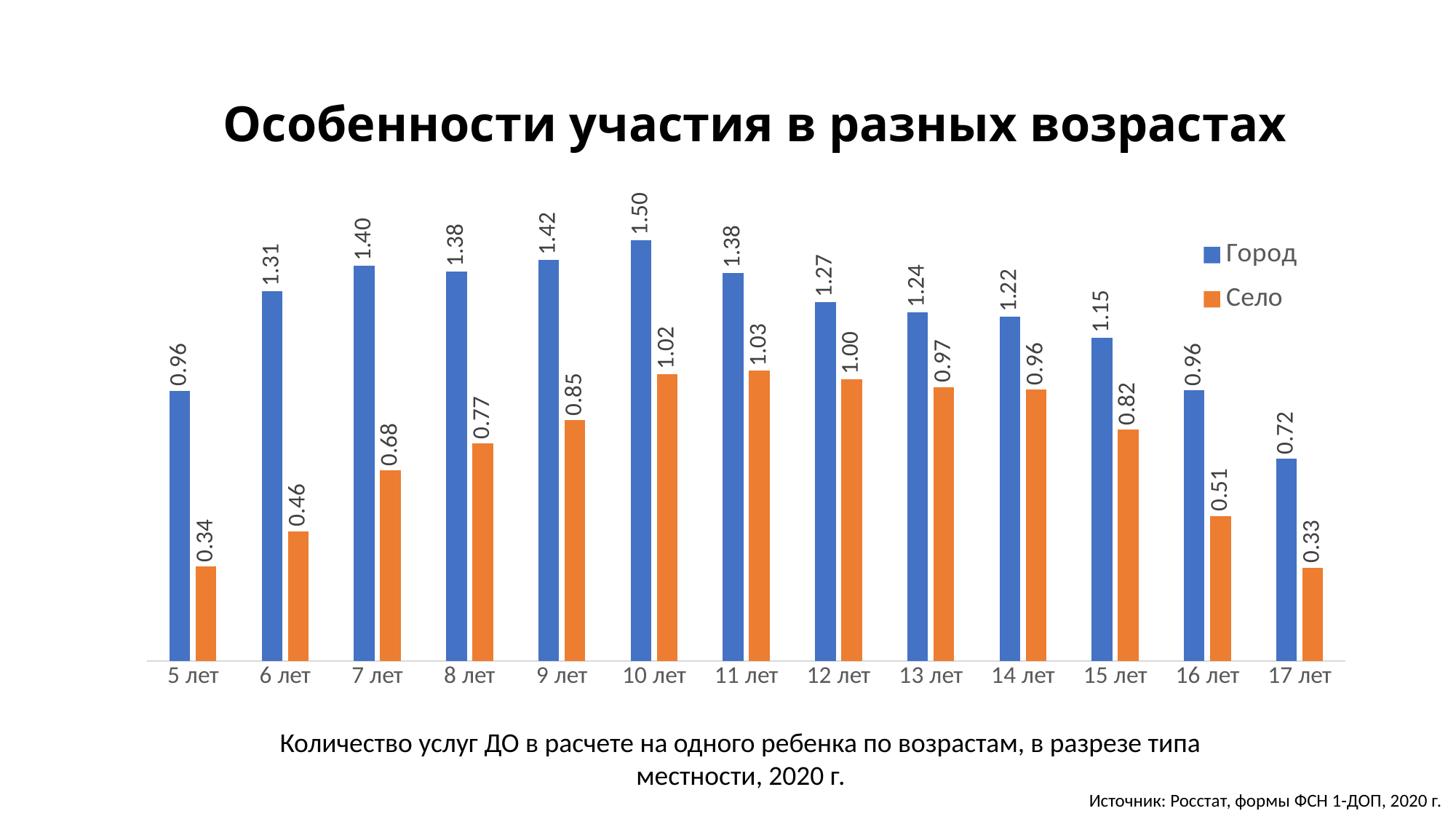
What is the value for Город at 10 лет? 1.50 Which is larger: the Город value at 6 лет or the Город value at 14 лет? 6 лет What is the value for Село at 8 лет? 0.77 What is the value for Село at 17 лет? 0.33 What kind of chart is shown on the slide? bar chart Which age group has the highest value for Город? 10 лет What is the difference between the Город and Село values at 10 лет? 0.48 Which age group has the lowest value for Город? 17 лет What is the value for Город at 15 лет? 1.15 How many age categories are shown on the x axis? 13 How many series does the legend list? 2 Do the Село values rise or fall from 5 лет to 11 лет? rise